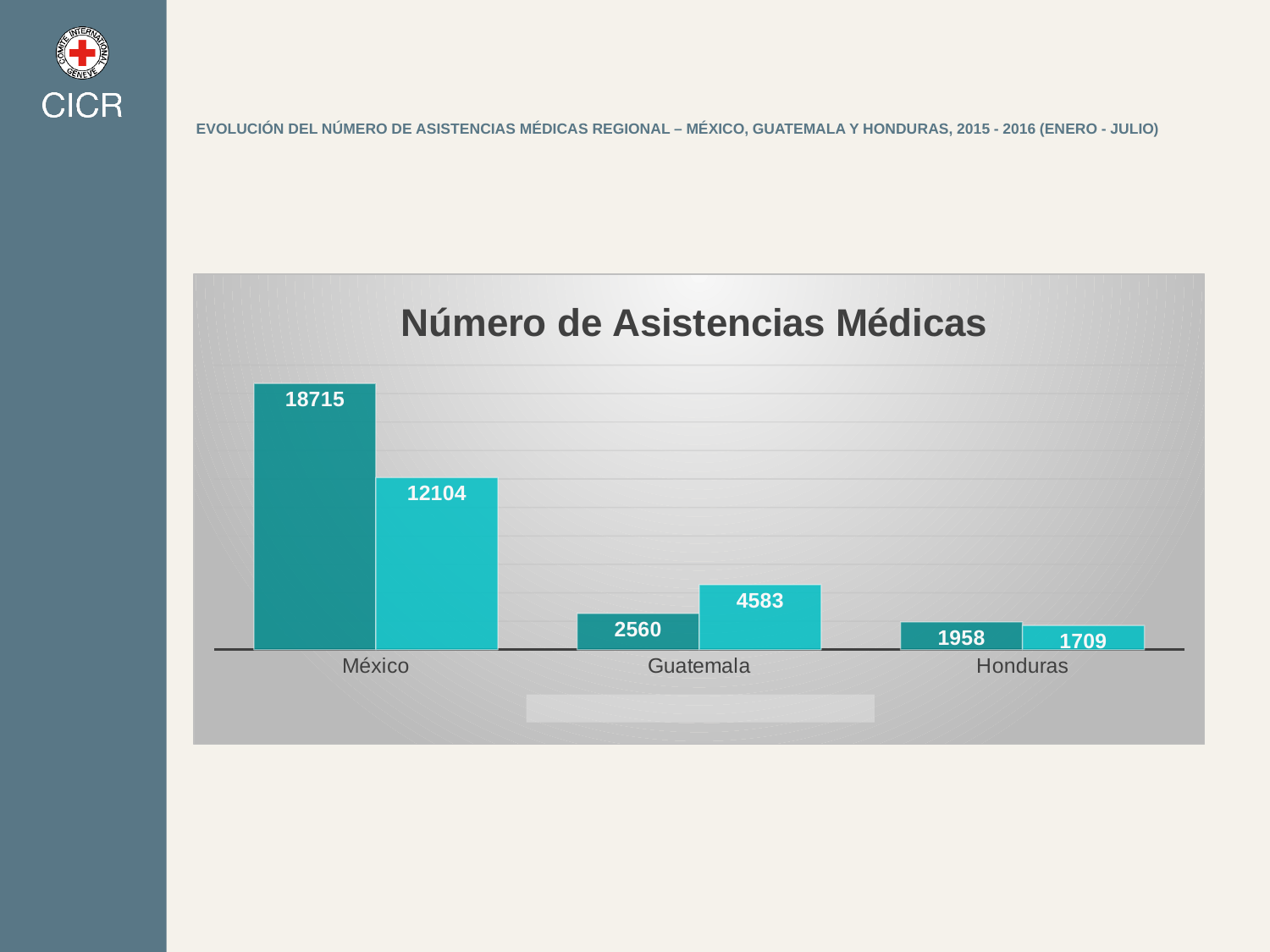
How many categories are shown on the x axis? 3 What is the value of the lighter teal bar for Guatemala? 4583 For Honduras, which bar is larger, the darker teal one or the lighter teal one? the darker teal one What kind of chart is shown on the slide? bar chart What is the value of the lighter teal bar for Honduras? 1709 Which category has the lowest value shown in the chart? Honduras What is the difference between the two bars for México? 6611 For Guatemala, which bar is larger, the darker teal one or the lighter teal one? the lighter teal one Which category has the tallest bar in the chart? México What is the difference between the two bars for Guatemala? 2023 What is the value of the darker teal bar for México? 18715 What is the title of the chart? Número de Asistencias Médicas